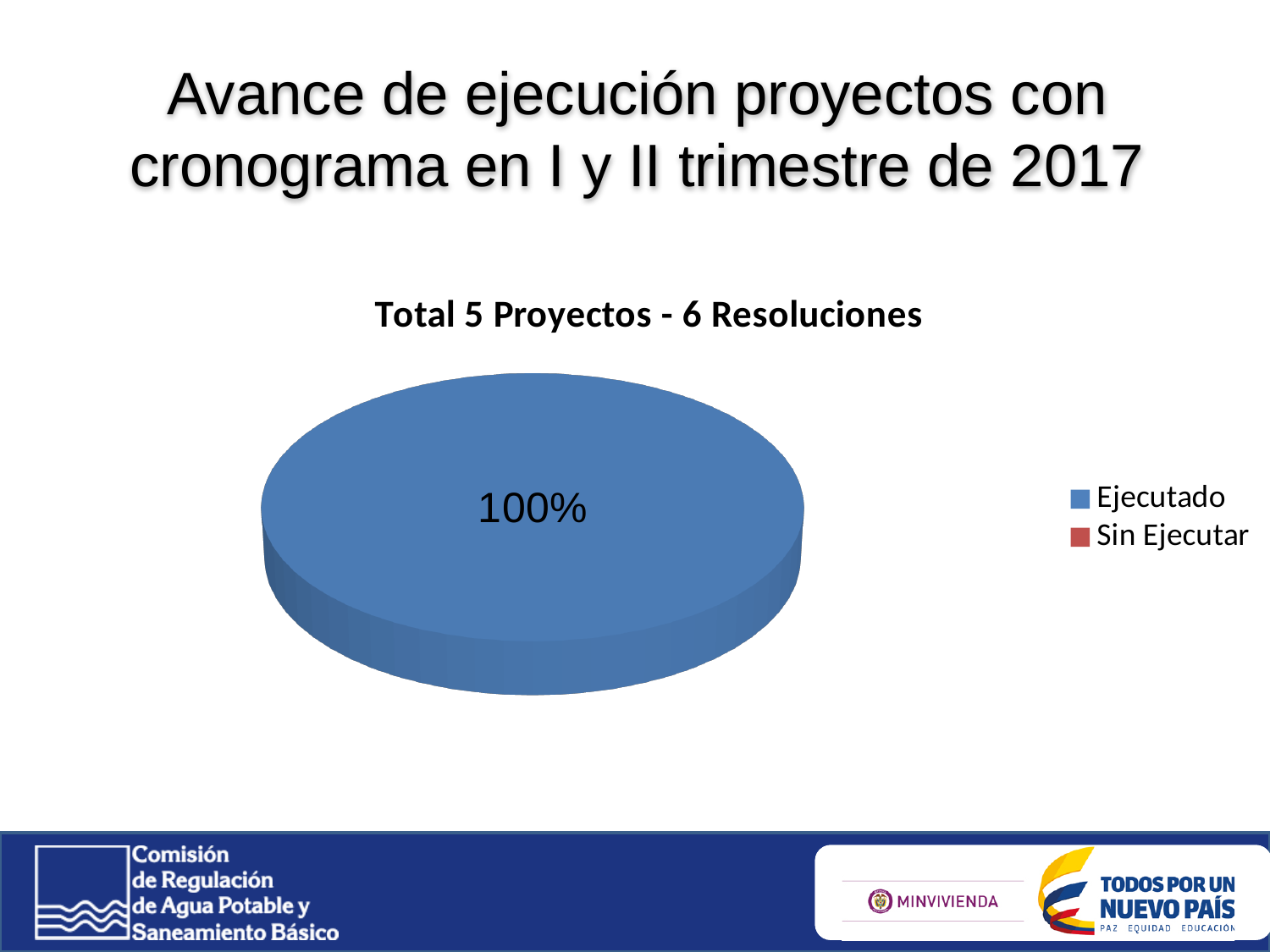
What is the title of the chart? Total 5 Proyectos - 6 Resoluciones Which category accounts for the entire pie? Ejecutado What colour is the Ejecutado slice in the pie chart? Blue Is the share for Ejecutado greater or less than 50%? greater Which is larger, the Ejecutado share or the Sin Ejecutar share? Ejecutado What percentage label is printed on the pie? 100% How many entries does the chart legend list? 2 What kind of chart is shown on the slide? Pie chart Which legend entry has no visible slice in the pie? Sin Ejecutar What share of the pie does the Ejecutado slice represent? 100%